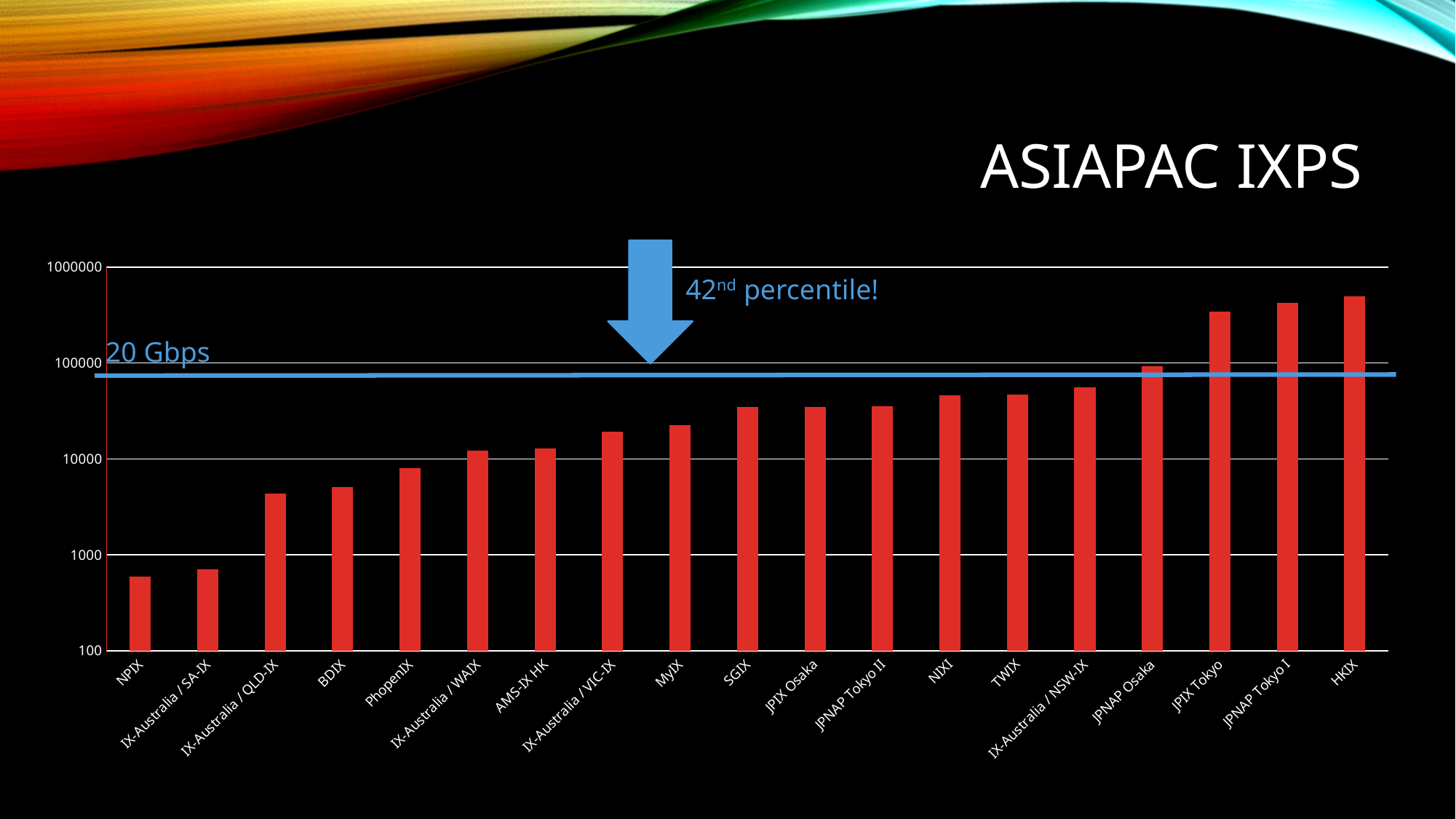
Which IXP has the highest bar in the chart? HKIX Is the value for HKIX greater or less than 100000? greater Is the value for MyIX greater or less than 10000? greater How many IXPs (categories) are plotted in the chart? 19 What label is attached to the horizontal blue line drawn across the chart? 20 Gbps Do the bar values rise or fall from left to right along the x axis? rise Is the value for BDIX greater or less than 10000? less What is the title of the slide? ASIAPAC IXPS Which has the larger value, JPIX Tokyo or BDIX? JPIX Tokyo Which IXP has the lowest bar in the chart? NPIX What kind of chart is shown on the slide? bar chart